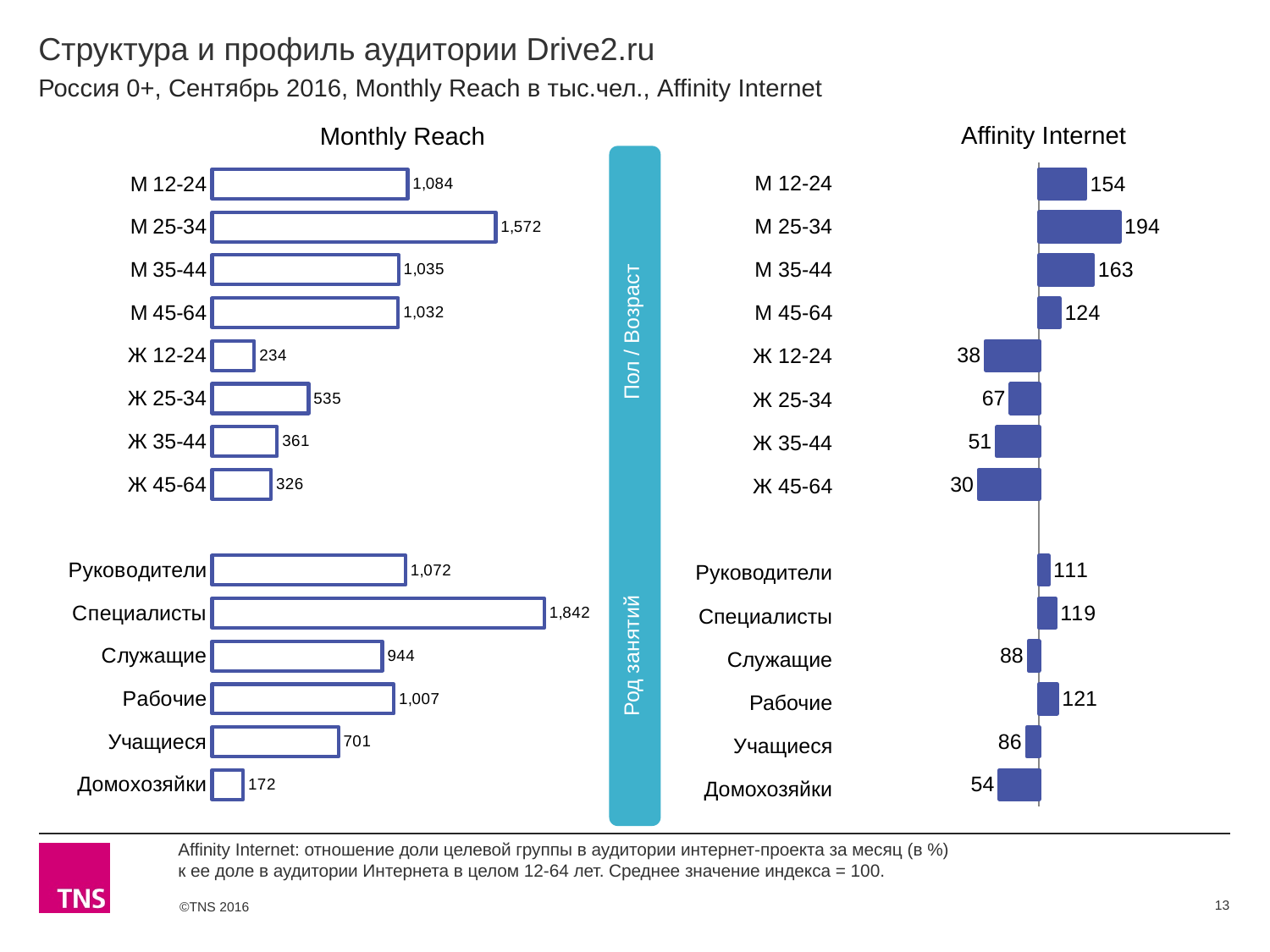
In the Monthly Reach chart, what is the difference between Специалисты and Руководители? 770 In the Monthly Reach chart, which category has the highest value? Специалисты In the Affinity Internet chart, what is the value for Домохозяйки? 54 What type of chart is the Monthly Reach chart? Bar chart In the Monthly Reach chart, what is the value for М 25-34? 1,572 In the Affinity Internet chart, what is the difference between М 35-44 and М 45-64? 39 In the Monthly Reach chart, which category has the lowest value? Домохозяйки In the Affinity Internet chart, what is the value for М 25-34? 194 In the Monthly Reach chart, what is the value for Ж 25-34? 535 In the Affinity Internet chart, which category has the lowest value? Ж 45-64 How many categories are shown in the Affinity Internet chart? 14 In the Affinity Internet chart, which is larger: Рабочие or Служащие? Рабочие